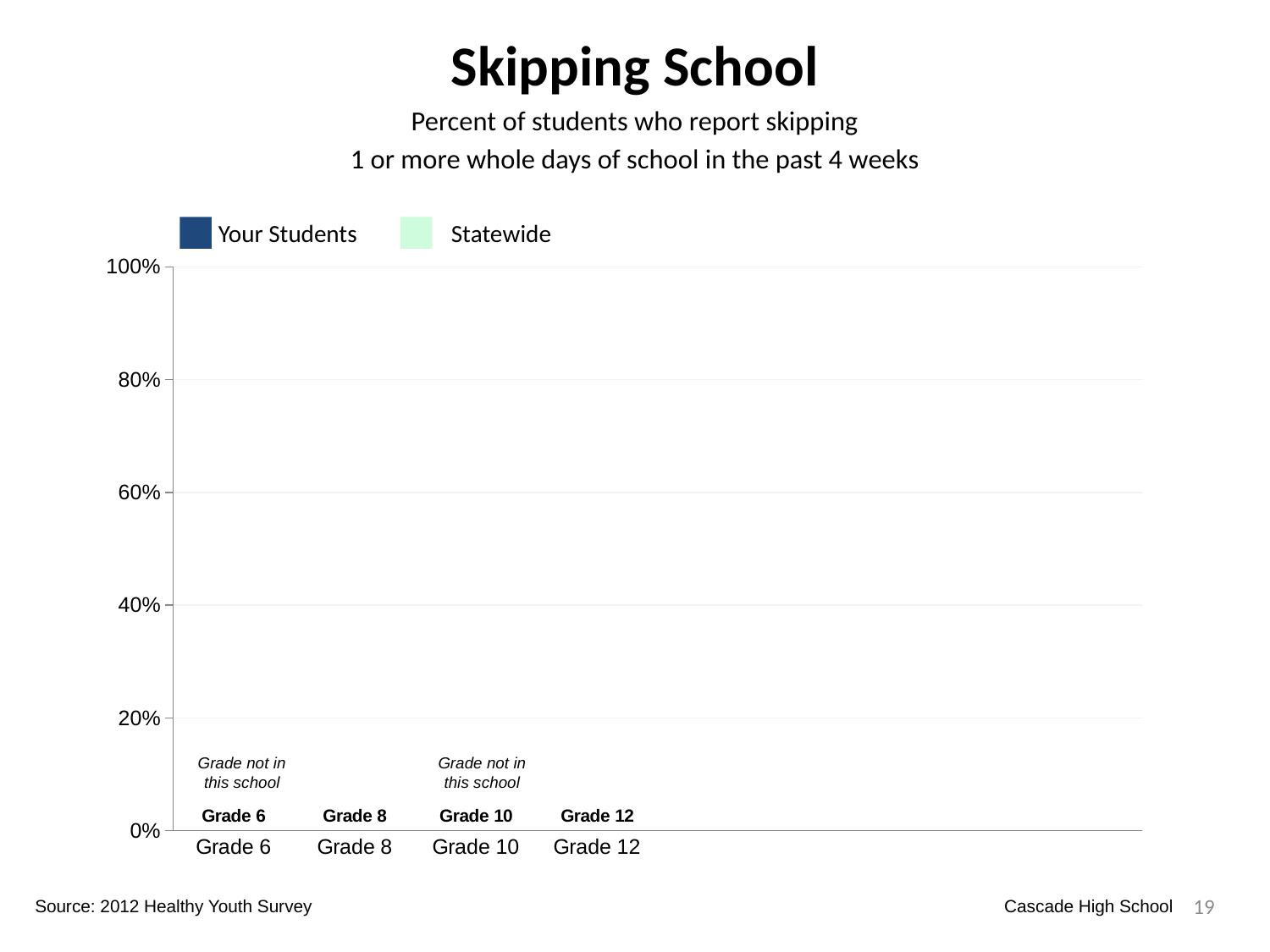
What are the two series named in the chart's legend? Your Students and Statewide What is the title of the chart? Skipping School What is the highest value shown on the chart's y axis? 100% How many grade categories are shown on the x axis of the chart? 4 Which grades are marked as 'Grade not in this school' on the chart? Grade 6 and Grade 10 How many series does the chart's legend list? 2